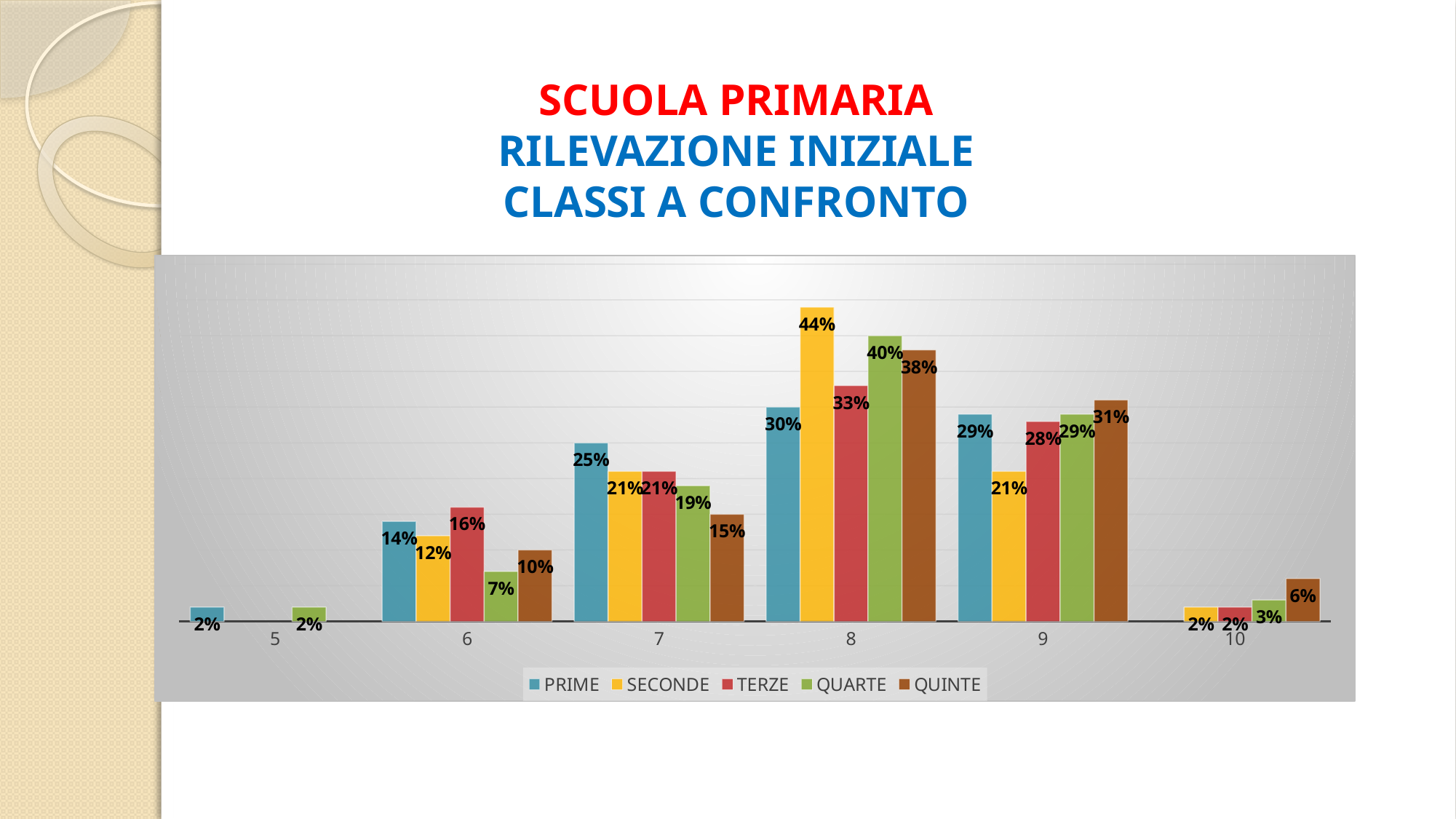
What is the value for SECONDE at category 8? 44% What is the value for QUINTE at category 10? 6% Which series has the highest value at category 8? SECONDE How many series does the legend list? 5 Which series has the lowest value at category 6? QUARTE What kind of chart is shown on the slide? bar chart What is the difference between the SECONDE and PRIME values at category 8? 14% Which is larger at category 9: the value for PRIME or the value for SECONDE? PRIME Which series is shown in yellow in the legend? SECONDE What is the value for QUINTE at category 6? 10% How many categories are shown on the x axis? 6 What is the value for PRIME at category 7? 25%